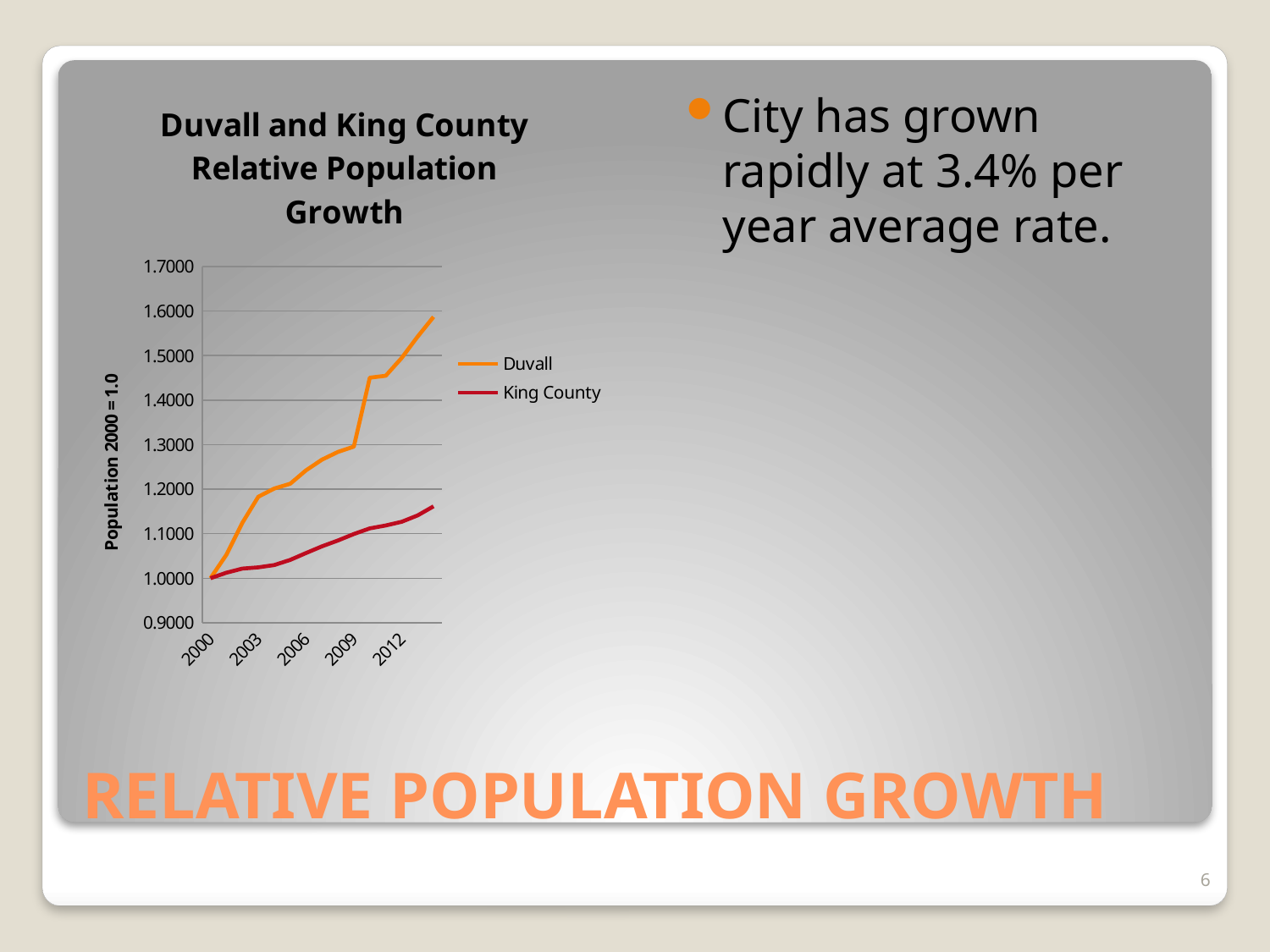
Do the values for Duvall rise or fall from 2000 to 2012? rise What kind of chart is shown on the slide? line chart What is the label on the vertical axis of the chart? Population 2000 = 1.0 Is the value for Duvall in 2009 greater or less than 1.2000? greater Is the value for Duvall in 2012 greater or less than 1.4000? greater What is the title of the chart? Duvall and King County Relative Population Growth What is the value for King County in 2000? 1.0000 Is the value for King County in 2012 greater or less than 1.2000? less What is the value for Duvall in 2000? 1.0000 How many year labels are shown on the x axis? 5 Which series has the higher value in 2012, Duvall or King County? Duvall How many series does the chart legend list? 2